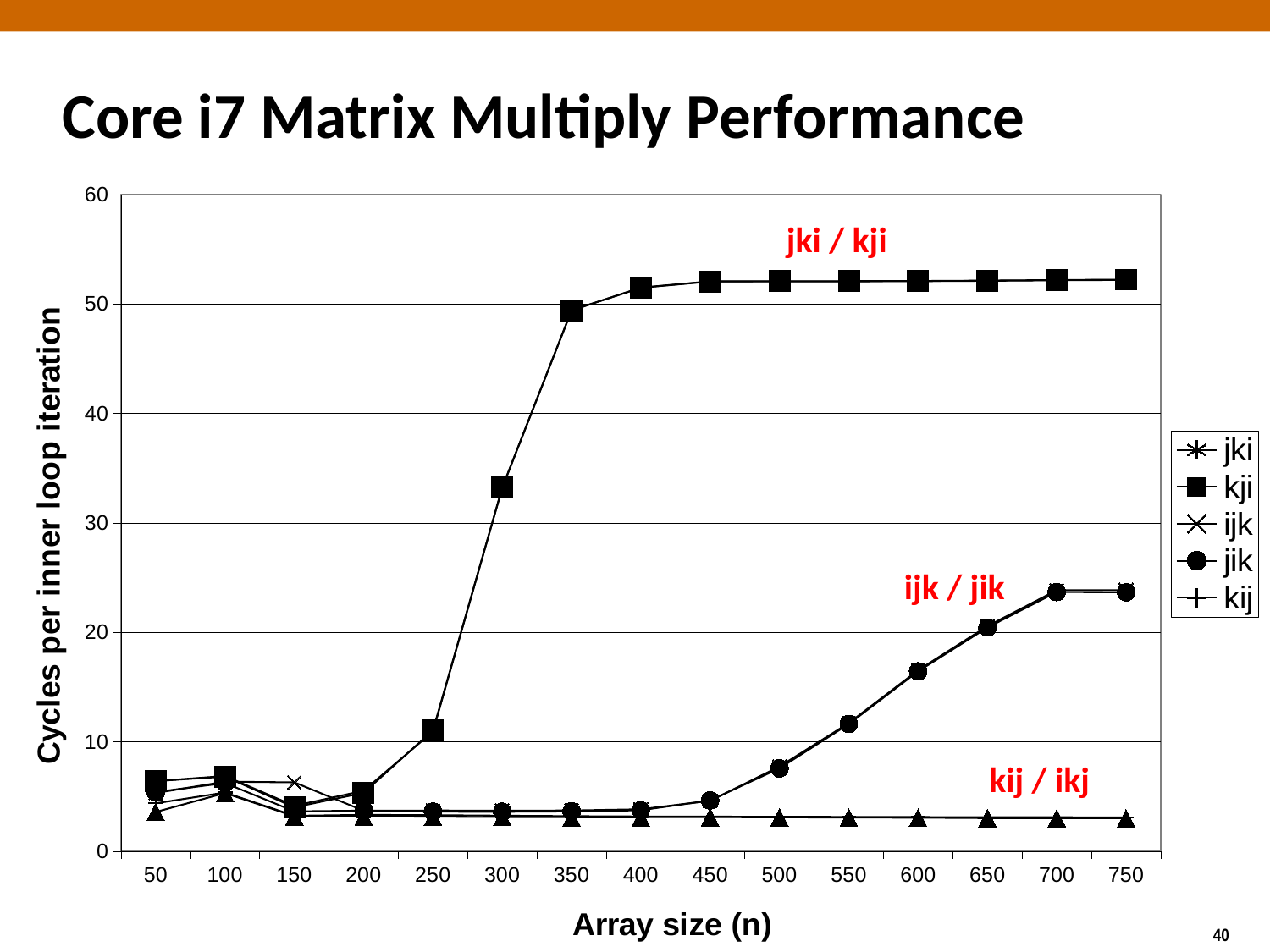
How many array size values are plotted along the x axis? 15 Is the value for kij at array size 750 greater or less than 10? less Is the value for kji at array size 350 greater or less than 40? greater How many series does the legend list? 5 Does the kji series rise or fall between array sizes 200 and 400? rise At array size 750, which is larger: the value for kji or the value for jik? kji At array size 500, which is larger: the value for jik or the value for kij? jik Is the value for jik at array size 750 greater or less than 20? greater What is the title of the x axis? Array size (n) What kind of chart is shown on the slide? line chart